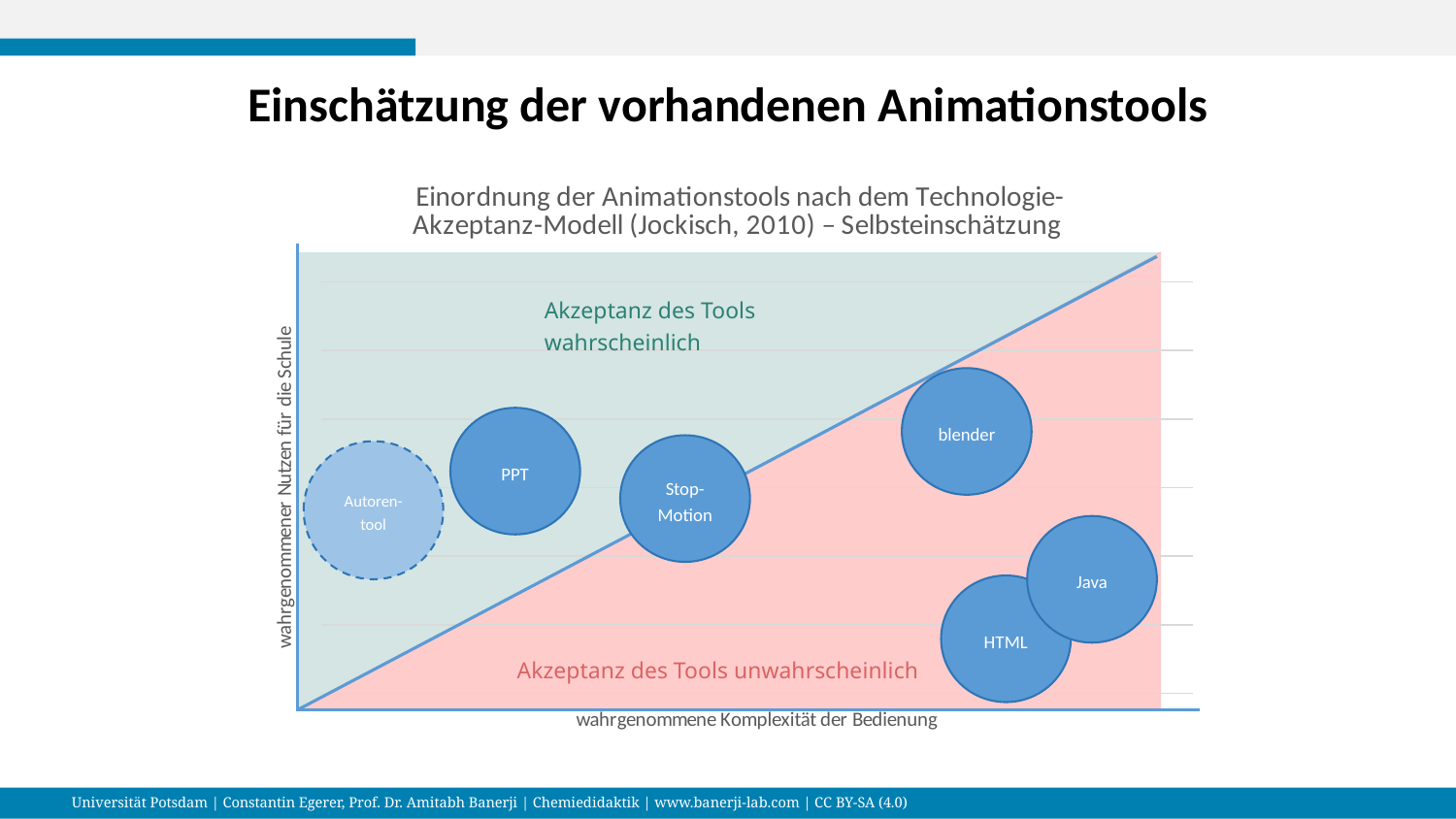
Which tool is plotted highest on the y axis (highest perceived benefit for school)? blender How many animation tools are plotted as bubbles in the chart? 6 What is the label of the x axis? wahrgenommene Komplexität der Bedienung In which region of the chart is HTML located? Akzeptanz des Tools unwahrscheinlich What is the title of the chart? Einordnung der Animationstools nach dem Technologie-Akzeptanz-Modell (Jockisch, 2010) – Selbsteinschätzung Which tool is plotted furthest to the right on the x axis (highest perceived complexity)? Java Which is plotted higher on the y axis, PPT or HTML? PPT What kind of chart is shown on the slide? bubble chart Which is plotted further to the right on the x axis, Autorentool or Java? Java Which tool is plotted furthest to the left on the x axis (lowest perceived complexity)? Autorentool In which region of the chart is PPT located? Akzeptanz des Tools wahrscheinlich Which tool is plotted lowest on the y axis (lowest perceived benefit for school)? HTML